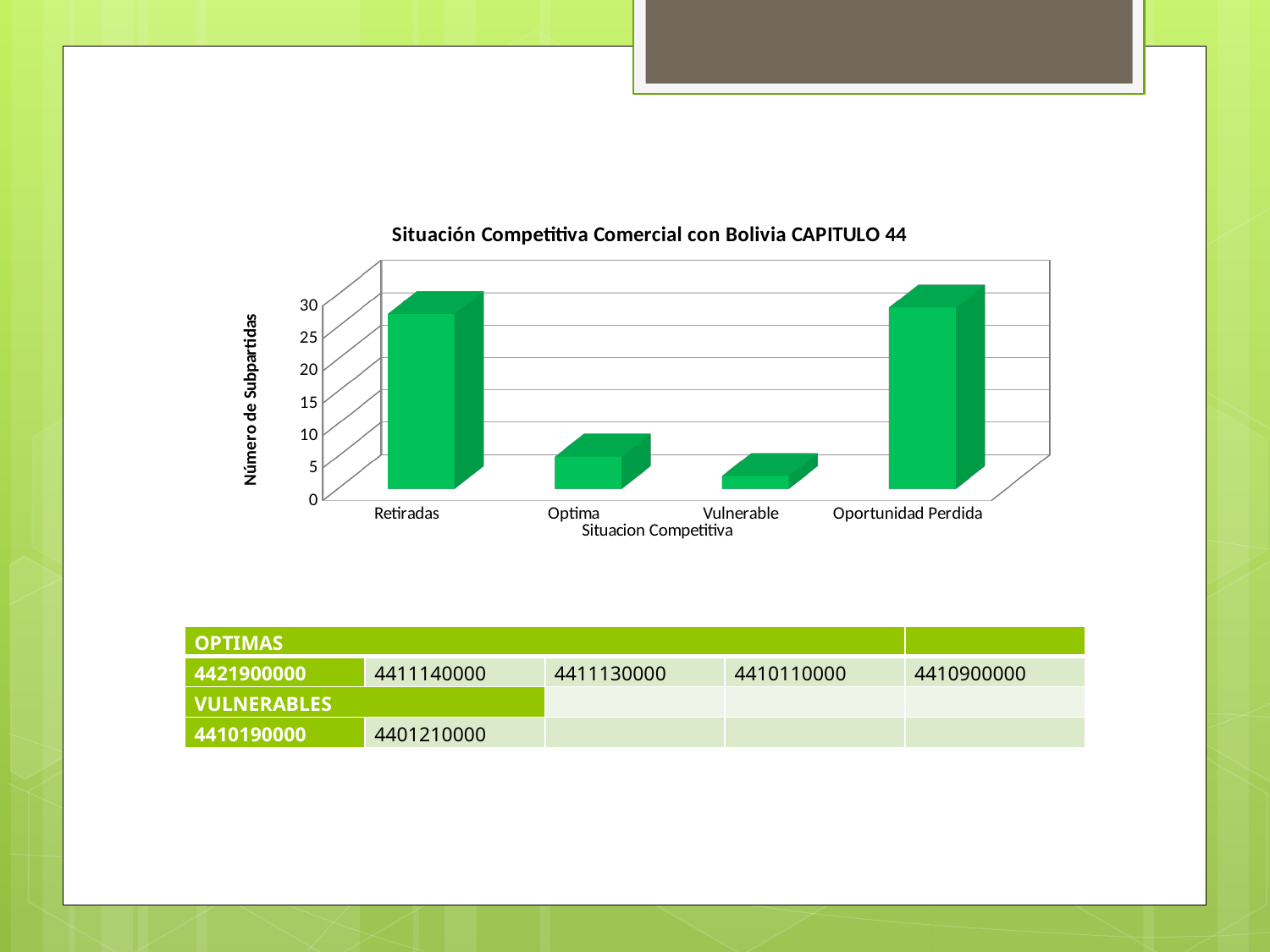
What is the title of the chart? Situación Competitiva Comercial con Bolivia CAPITULO 44 How many categories are shown on the x axis of the chart? 4 Is the value for Optima greater or less than 10? less Which category has the lowest value in the chart? Vulnerable Is the value for Oportunidad Perdida greater or less than 25? greater What is the label of the vertical axis of the chart? Número de Subpartidas Which is larger, the value for Oportunidad Perdida or the value for Vulnerable? Oportunidad Perdida Is the value for Vulnerable greater or less than 5? less Which is larger, the value for Retiradas or the value for Optima? Retiradas What kind of chart is shown on the slide? bar chart